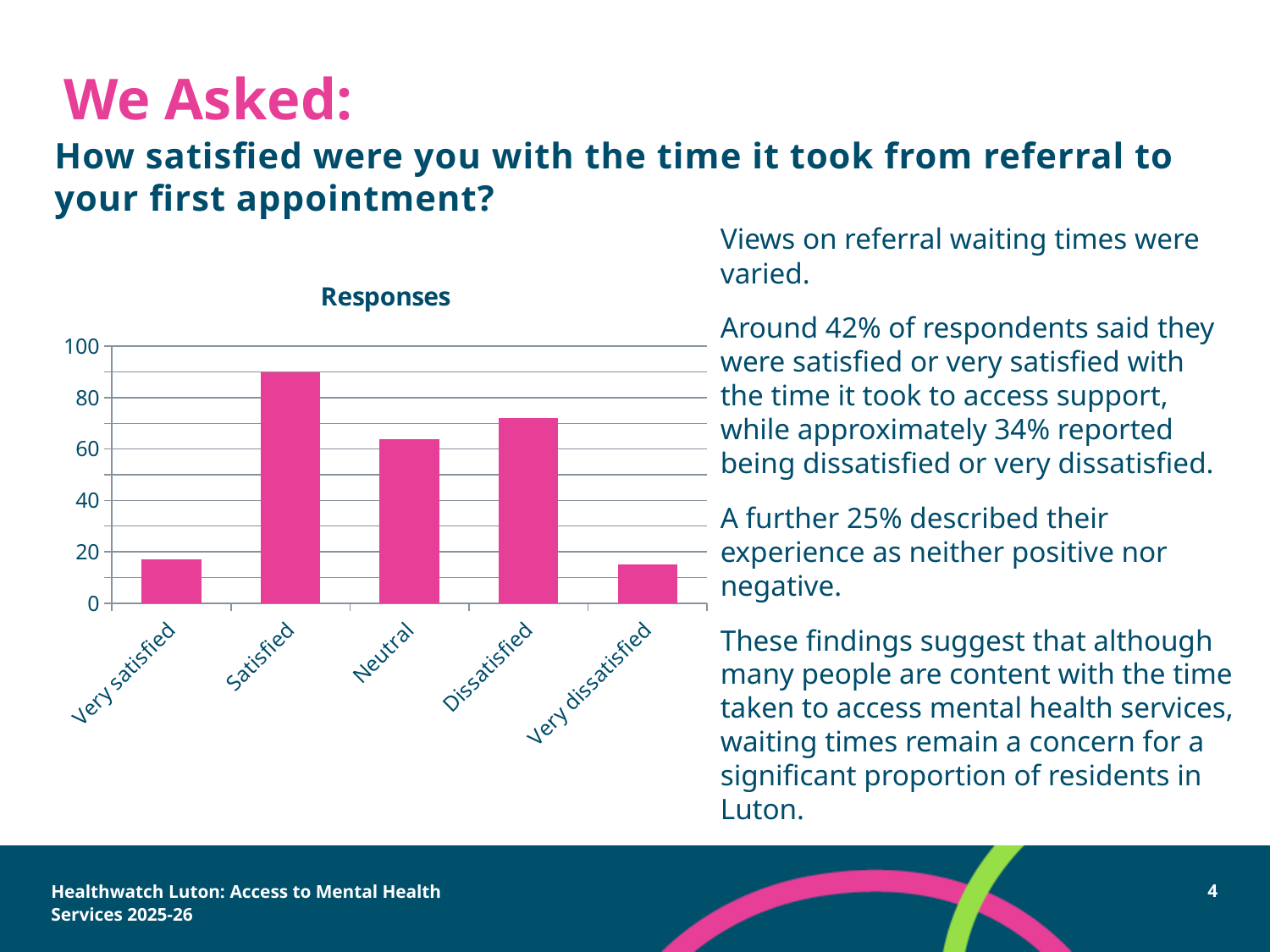
What kind of chart is shown on the slide? bar chart Which is larger, the value for Neutral or the value for Dissatisfied? Dissatisfied Is the value for Very satisfied greater or less than 20? less What is the title of the chart? Responses Which category has the highest value in the chart? Satisfied Is the value for Dissatisfied greater or less than 80? less What colour are the bars in the chart? pink Which is larger, the value for Satisfied or the value for Dissatisfied? Satisfied Is the value for Satisfied greater or less than 80? greater How many categories are shown on the x axis of the chart? 5